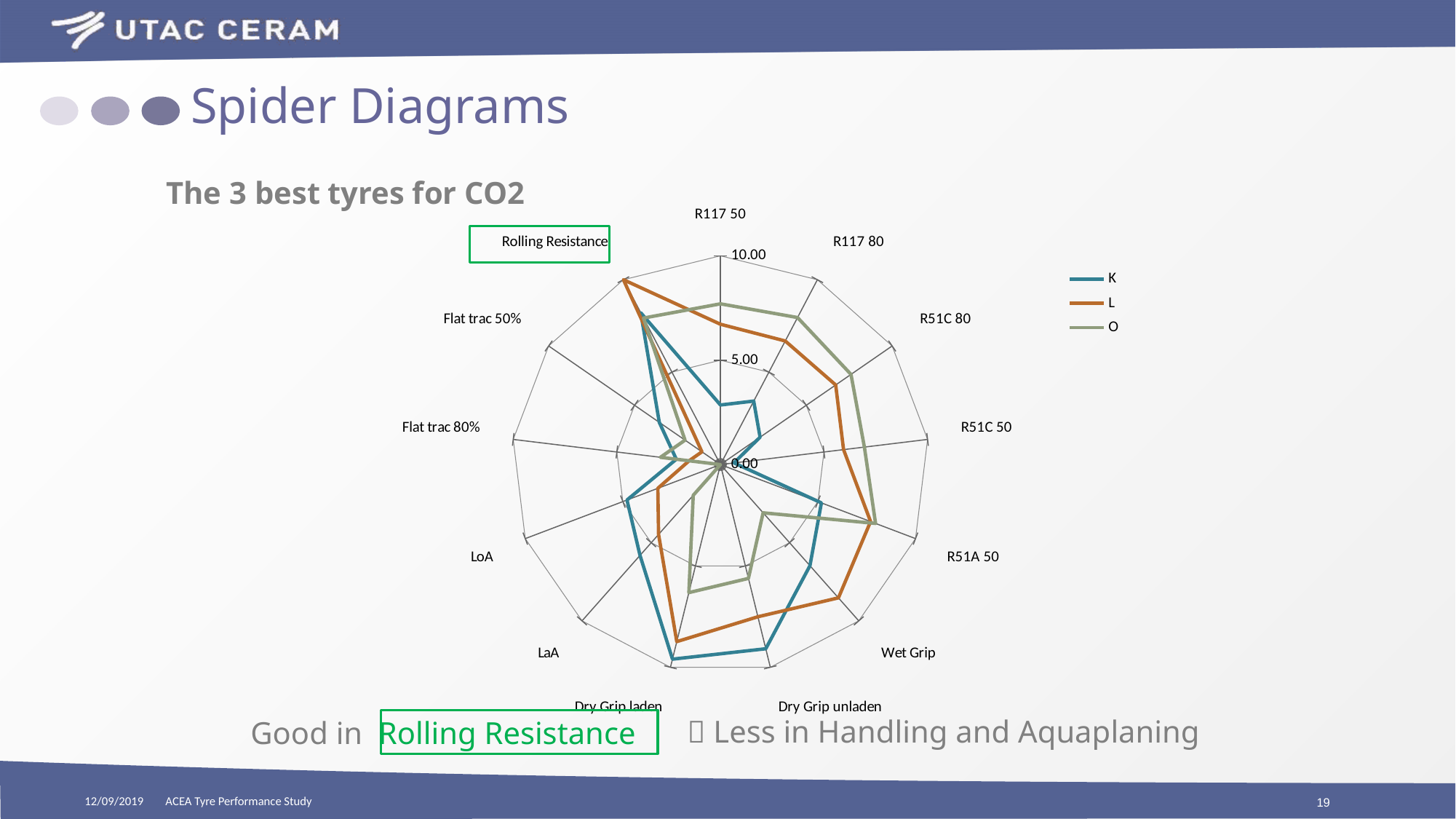
For R51C 50, which series has the larger value, K or L? L How many series does the legend list? 3 What is the maximum value shown on the radial axis? 10.00 For Wet Grip, which series has the larger value, K or O? K Is the value of series K for Flat trac 80% greater or less than 5.00? less How many categories (axes) does the spider chart have? 13 Is the value of series K for R117 50 greater or less than 5.00? less Which series are listed in the legend? K, L, O What kind of chart is shown on the slide? Radar chart Is the value of series K for Wet Grip greater or less than 5.00? greater